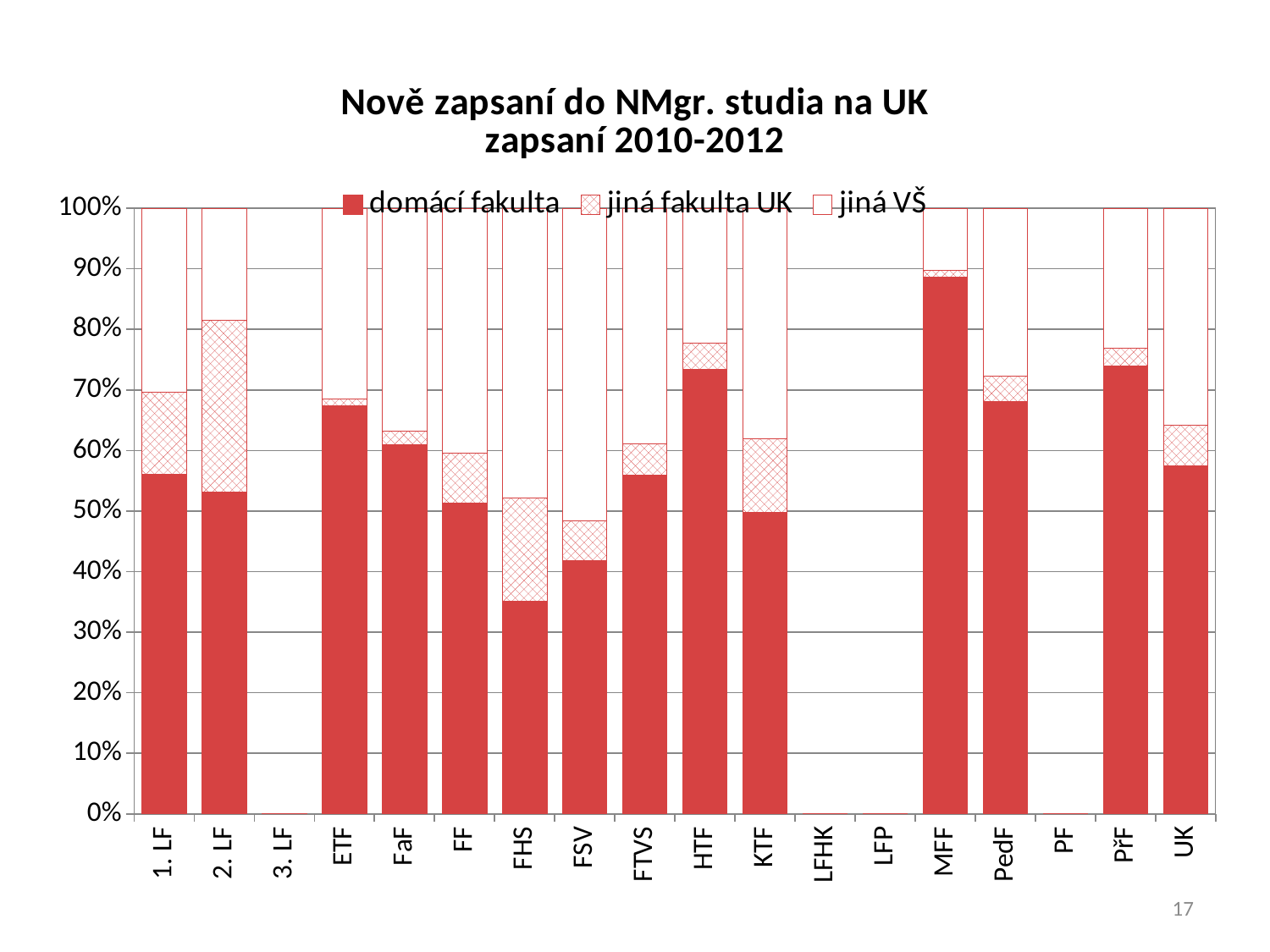
Which has a larger jiná fakulta UK share, 1. LF or 2. LF? 2. LF Is the domácí fakulta share for UK greater or less than 50%? greater Which category has the highest share of domácí fakulta? MFF Is the domácí fakulta share for FHS greater or less than 40%? less What is the total of the stacked bar for MFF? 100% Which has a larger domácí fakulta share, FSV or FHS? FSV What kind of chart is shown on the slide? stacked bar chart How many series does the legend list? 3 What is the title of the chart? Nově zapsaní do NMgr. studia na UK zapsaní 2010-2012 Is the domácí fakulta share for MFF greater or less than 80%? greater How many categories are shown on the x axis? 18 Among the categories with plotted bars, which has the lowest share of domácí fakulta? FHS